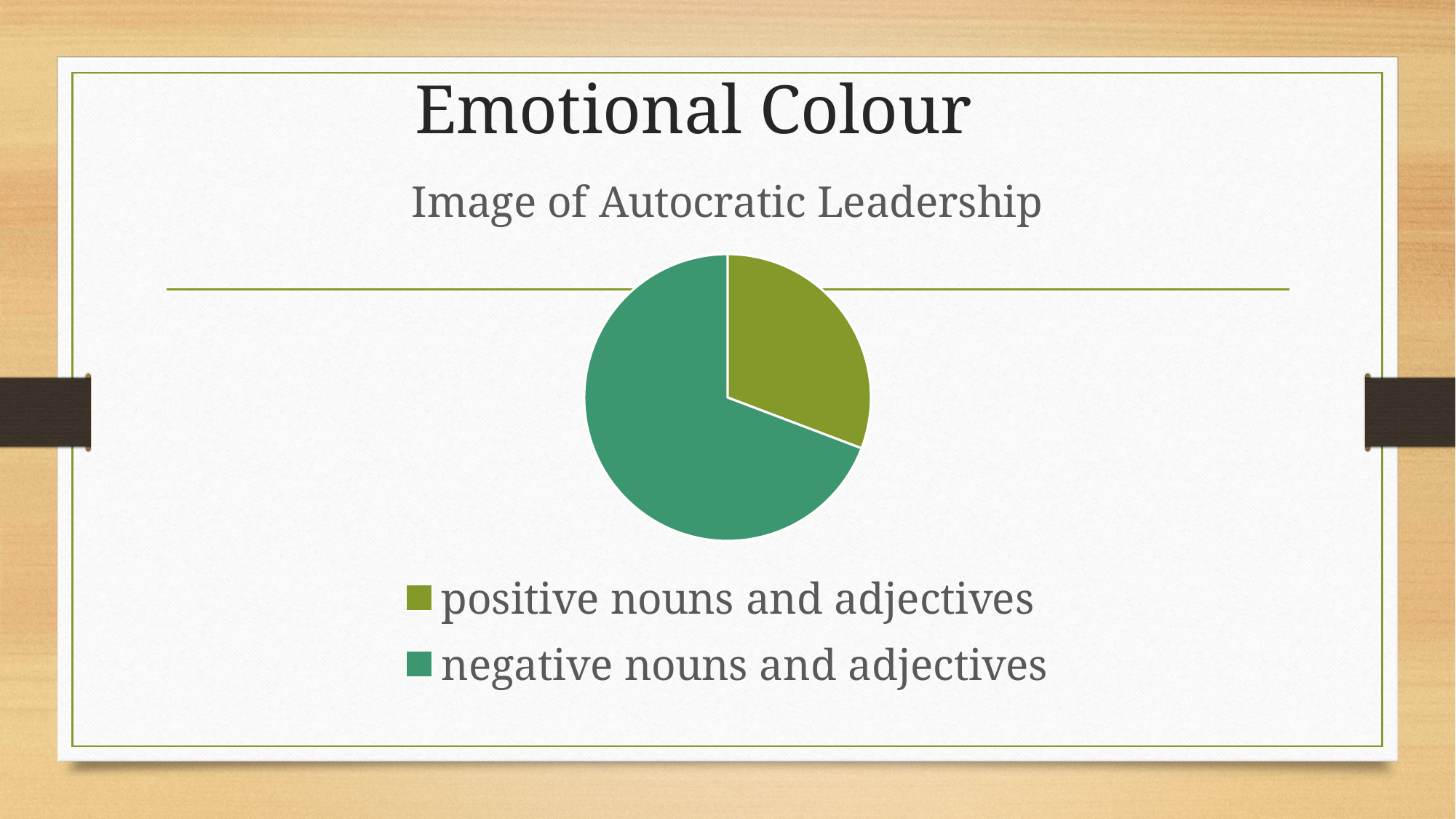
Which category takes up the largest share of the pie chart? negative nouns and adjectives What is the title of the pie chart? Image of Autocratic Leadership What kind of chart is shown on the slide? pie chart Which category takes up the smallest share of the pie chart? positive nouns and adjectives Does the slice for negative nouns and adjectives cover more or less than half of the pie? more Which colour represents positive nouns and adjectives in the pie chart? olive green How many slices does the pie chart have? 2 Which slice is larger: positive nouns and adjectives or negative nouns and adjectives? negative nouns and adjectives How many entries does the legend of the pie chart list? 2